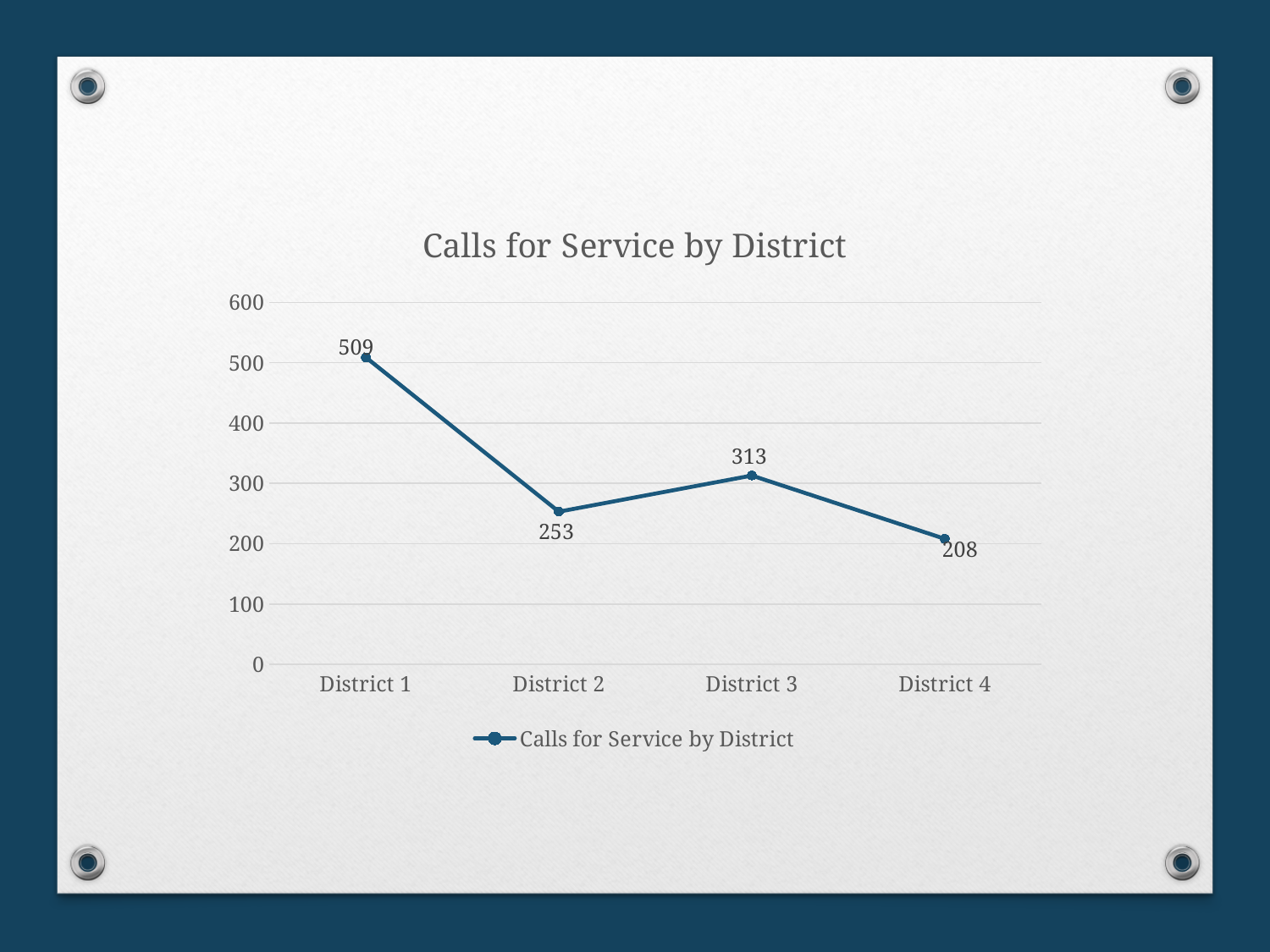
What is the difference between the values for District 3 and District 4? 105 What kind of chart is shown on the slide? line chart Which district has the highest number of calls for service? District 1 Which is larger, the value for District 2 or District 3? District 3 What is the value for District 1? 509 How many districts are shown on the x axis? 4 What is the title of the chart? Calls for Service by District What is the value for District 3? 313 What is the difference between the values for District 1 and District 2? 256 Is the value for District 2 greater or less than 300? less What is the value for District 4? 208 Which district has the lowest number of calls for service? District 4